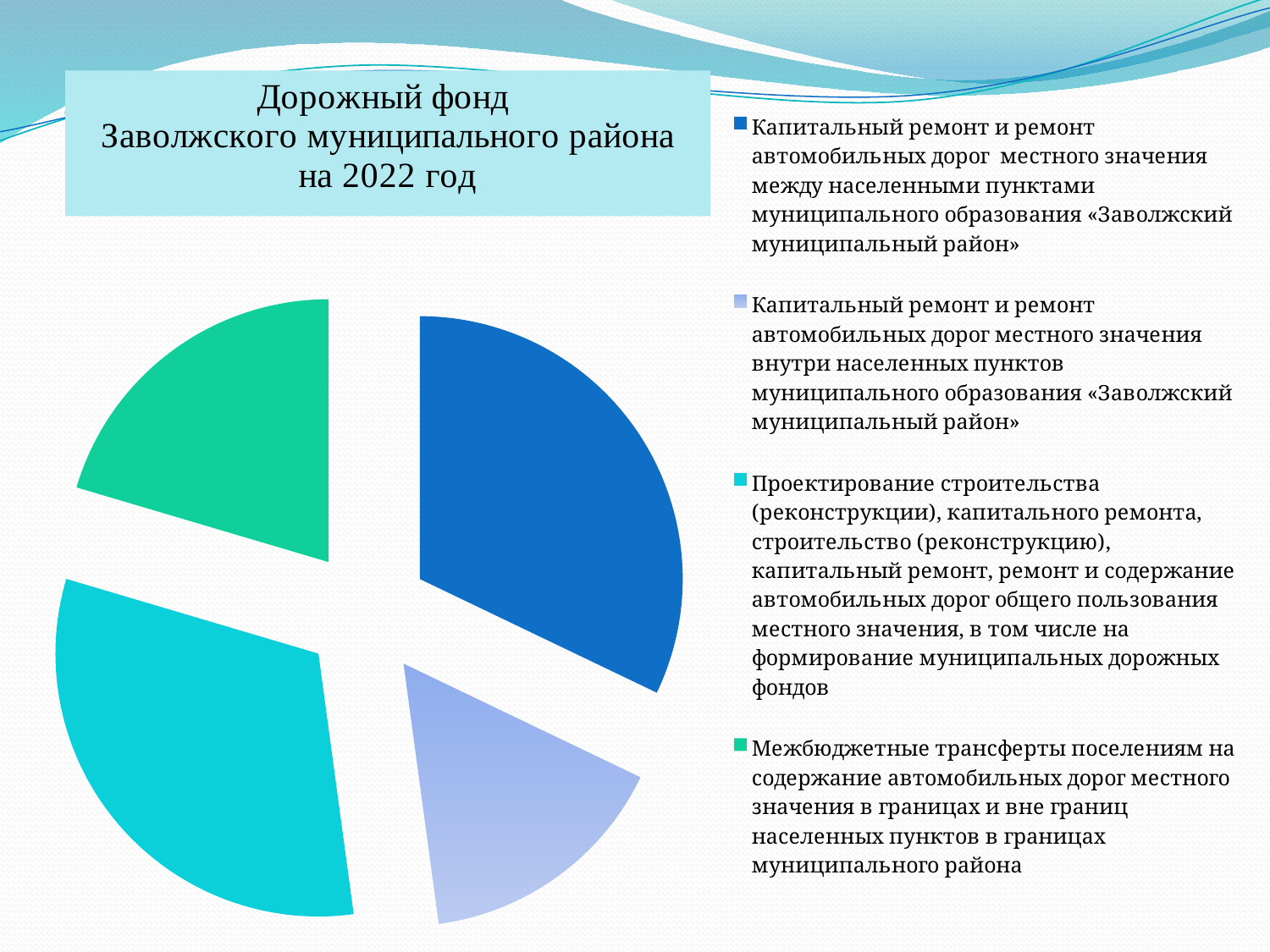
What colour is the slice for «Проектирование строительства (реконструкции)...» in the pie chart? cyan (turquoise) What kind of chart is shown on the slide? pie chart How many slices does the pie chart have? 4 Which slice is larger: «Межбюджетные трансферты поселениям...» or «Капитальный ремонт и ремонт автомобильных дорог местного значения внутри населенных пунктов...»? Межбюджетные трансферты поселениям... Which category has the smallest slice in the pie chart? Капитальный ремонт и ремонт автомобильных дорог местного значения внутри населенных пунктов муниципального образования «Заволжский муниципальный район» What is the title of the chart on the slide? Дорожный фонд Заволжского муниципального района на 2022 год How many entries does the legend of the pie chart list? 4 Which slice is larger: «Проектирование строительства (реконструкции)...» or «Капитальный ремонт и ремонт автомобильных дорог местного значения внутри населенных пунктов...»? Проектирование строительства (реконструкции)...